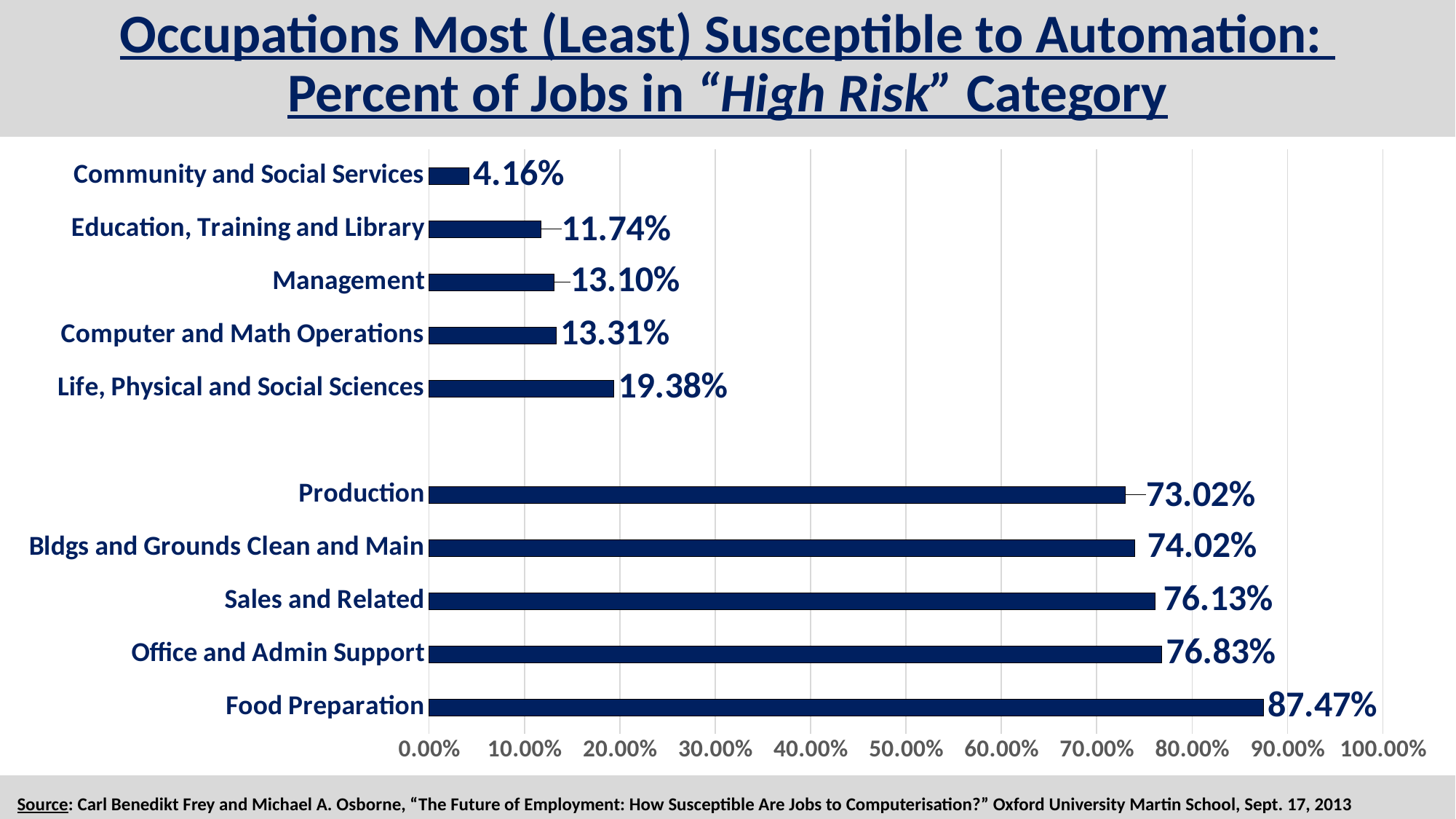
What kind of chart is shown on the slide? bar chart Which occupation has the highest percent of jobs in the high risk category? Food Preparation What is the maximum value shown on the horizontal axis? 100.00% What is the value for Community and Social Services? 4.16% How many occupation categories are shown in the chart? 10 What is the difference between the values for Food Preparation and Community and Social Services? 83.31% Which occupation has the lowest percent of jobs in the high risk category? Community and Social Services What is the value for Management? 13.10% Which is larger, the value for Office and Admin Support or the value for Bldgs and Grounds Clean and Main? Office and Admin Support Is the value for Life, Physical and Social Sciences greater or less than 20.00%? less What is the value for Food Preparation? 87.47% What is the difference between the values for Sales and Related and Production? 3.11%